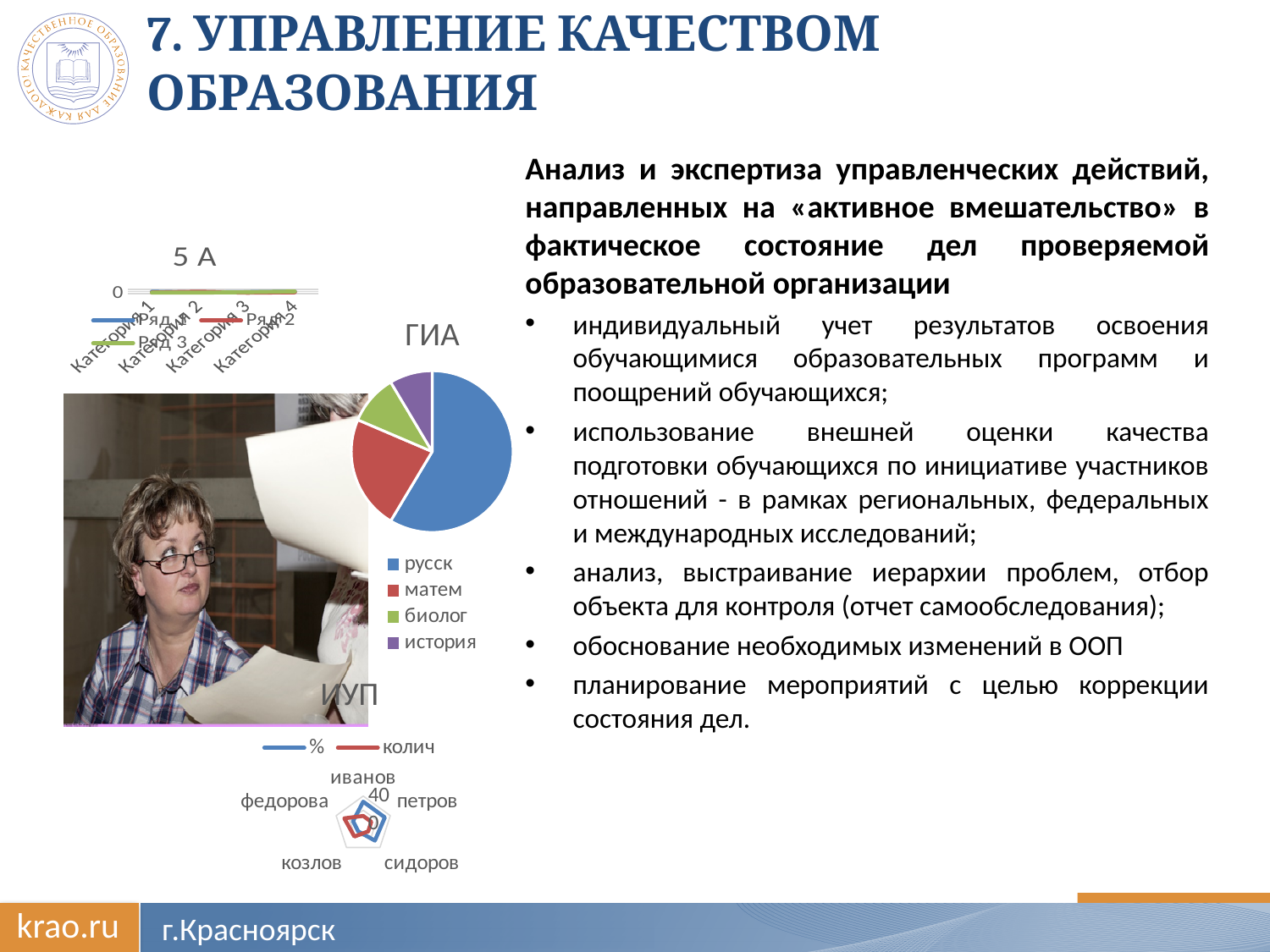
In the ГИА pie chart, which slice is larger, матем or биолог? матем How many series does the legend of the chart titled 5 А list? 3 How many series does the legend of the ИУП chart list? 2 What kind of chart is the chart titled ИУП? radar chart How many categories are shown around the ИУП radar chart? 5 How many categories does the legend of the ГИА pie chart list? 4 What are the two series named in the legend of the ИУП chart? % and колич What kind of chart is the chart titled ГИА? pie chart In the ГИА pie chart, which slice is larger, русск or матем? русск In the ГИА pie chart, which colour represents история? purple In the ГИА pie chart, which category has the largest slice? русск How many categories are shown on the x axis of the chart titled 5 А? 4